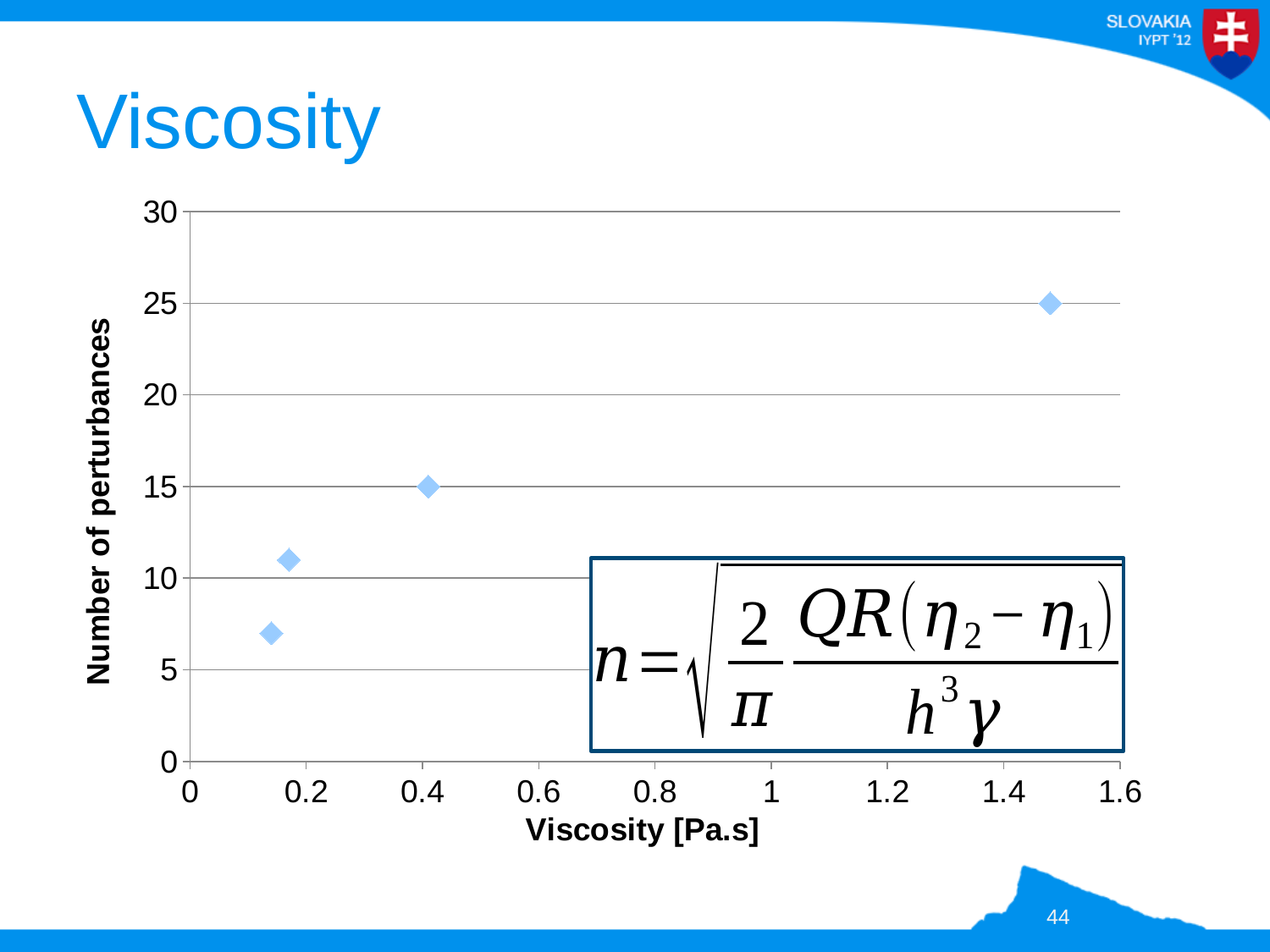
What is the difference in number of perturbances between the rightmost point and the point at about 0.4 Pa.s? 10 Is the viscosity of the rightmost data point greater or less than 1.4 Pa.s? greater How many data points are plotted on the chart? 4 What is the number of perturbances for the data point at a viscosity of about 0.4 Pa.s? 15 What is the label of the x axis? Viscosity [Pa.s] Which data point has the lowest number of perturbances? the leftmost point Is the number of perturbances for the leftmost data point greater or less than 10? less What is the number of perturbances for the rightmost data point? 25 What kind of chart is shown on the slide? scatter chart Which data point has the highest number of perturbances? the rightmost point What is the label of the y axis? Number of perturbances Do the number of perturbances rise or fall as viscosity increases along the x axis? rise